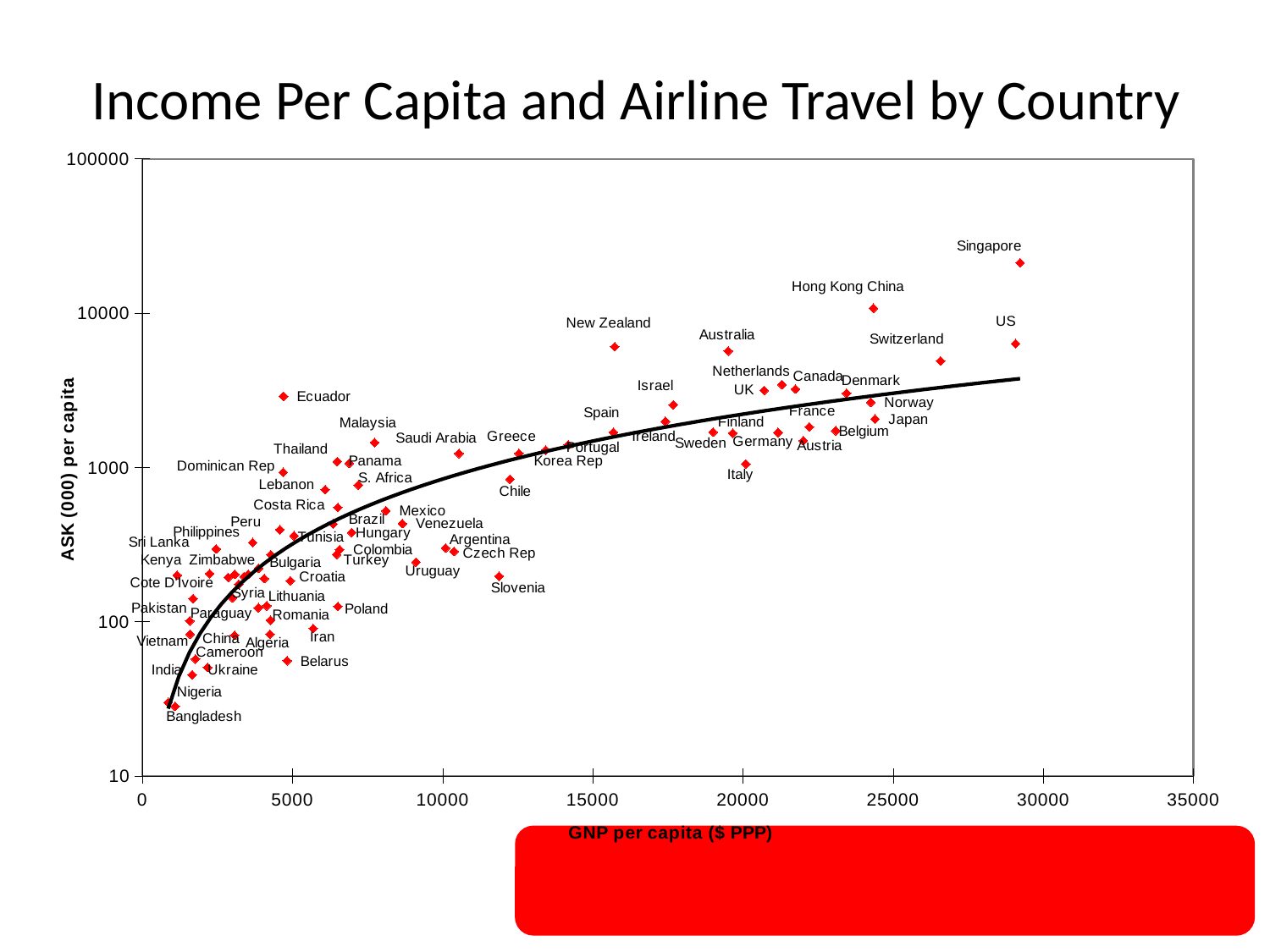
What kind of chart is shown on the slide? scatter chart What is the label of the vertical axis? ASK (000) per capita Is the ASK (000) per capita for Belarus greater or less than 100? less Is the ASK (000) per capita for Chile greater or less than 1000? less Is the GNP per capita for Greece greater or less than 10000? greater Does ASK (000) per capita generally rise or fall as GNP per capita increases along the x axis? rise Which country has the highest ASK (000) per capita? Singapore What is the title of the chart? Income Per Capita and Airline Travel by Country Which country has the highest GNP per capita? Singapore Which has a higher ASK (000) per capita, Hong Kong China or Switzerland? Hong Kong China Which country has the lowest ASK (000) per capita? Bangladesh